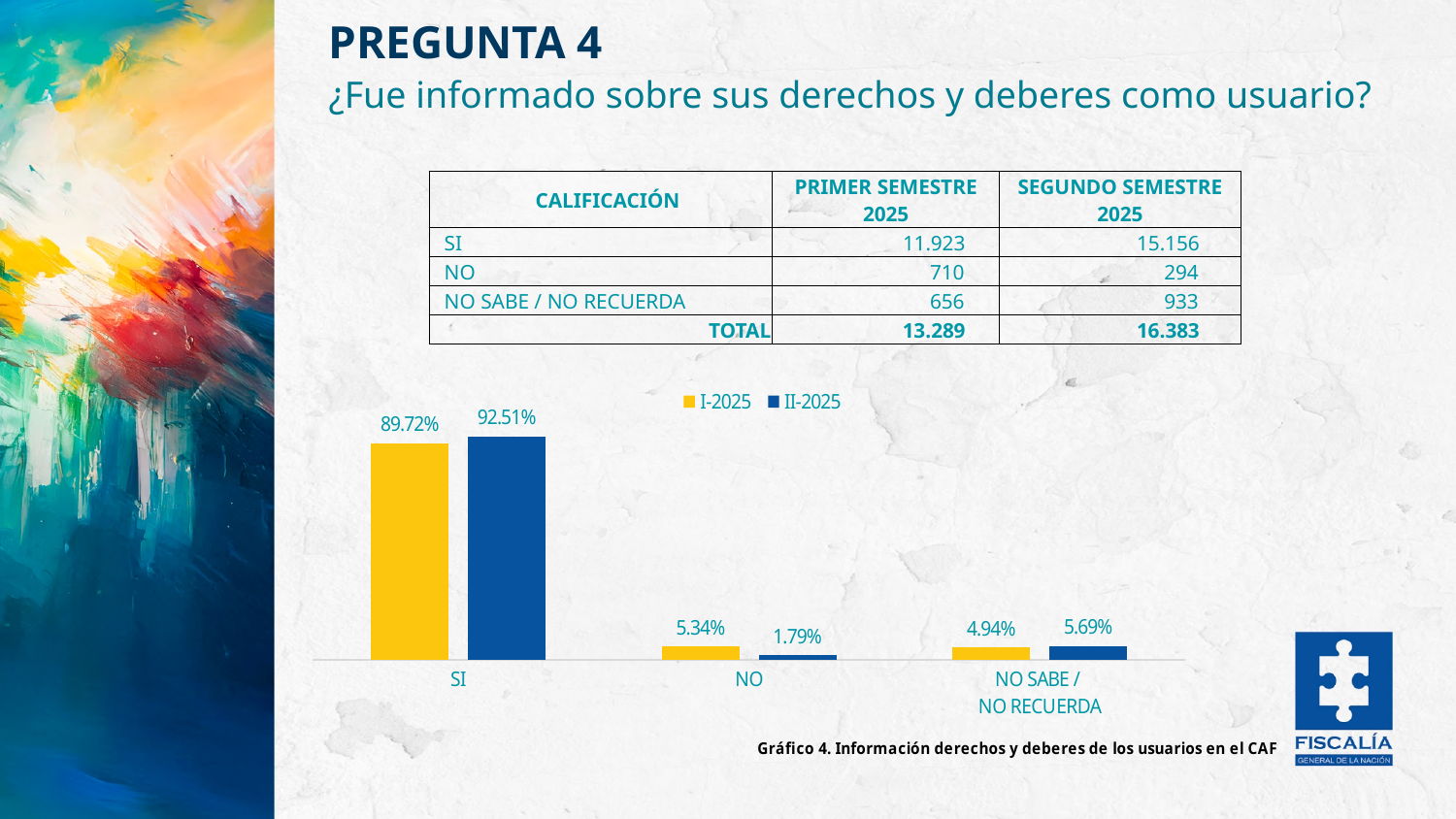
Which is larger for NO: the I-2025 value or the II-2025 value? I-2025 What is the value for SI in the I-2025 series? 89.72% How many categories are shown on the x axis of the chart? 3 What are the two series names listed in the chart legend? I-2025 and II-2025 What is the difference between the II-2025 and I-2025 values for SI? 2.79% What is the value for NO in the II-2025 series? 1.79% Which category has the lowest value in the II-2025 series? NO What is the value for SI in the II-2025 series? 92.51% What is the value for NO SABE / NO RECUERDA in the I-2025 series? 4.94% How many series does the chart legend list? 2 Which category has the highest value in the II-2025 series? SI What kind of chart is shown on the slide? Bar chart